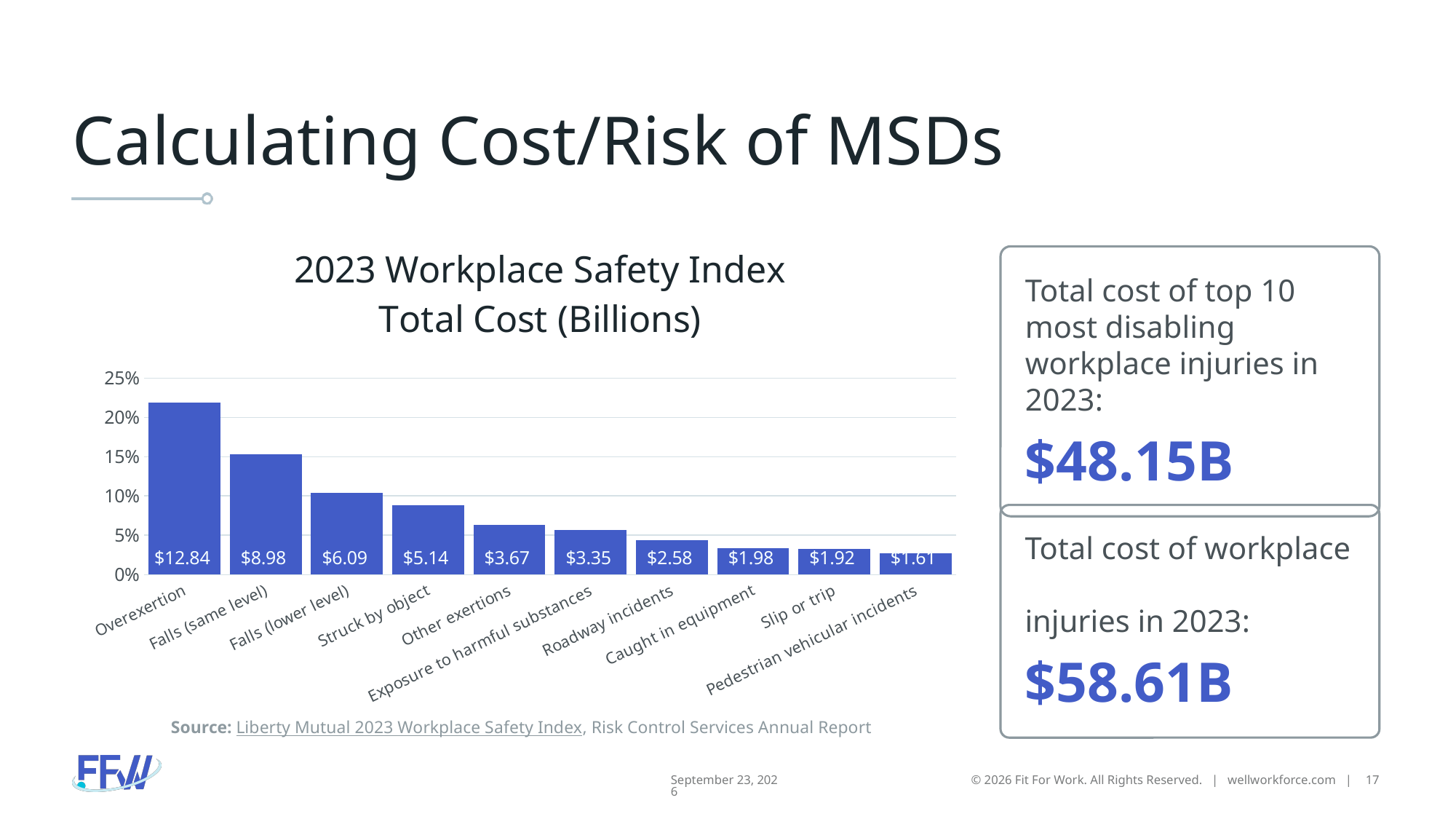
What is the data label shown for Roadway incidents? $2.58 Is the bar for Overexertion greater or less than 20% on the y axis? greater Which category has the lowest value in the chart? Pedestrian vehicular incidents What is the difference between the data labels for Overexertion and Falls (same level)? $3.86 What is the title of the chart? 2023 Workplace Safety Index Total Cost (Billions) What is the data label shown for Overexertion? $12.84 What is the data label shown for Struck by object? $5.14 Which category has the highest value in the chart? Overexertion What type of chart is shown on the slide? bar chart Which is larger, the value for Falls (lower level) or the value for Other exertions? Falls (lower level) Is the bar for Struck by object greater or less than 10% on the y axis? less How many categories are shown in the chart? 10